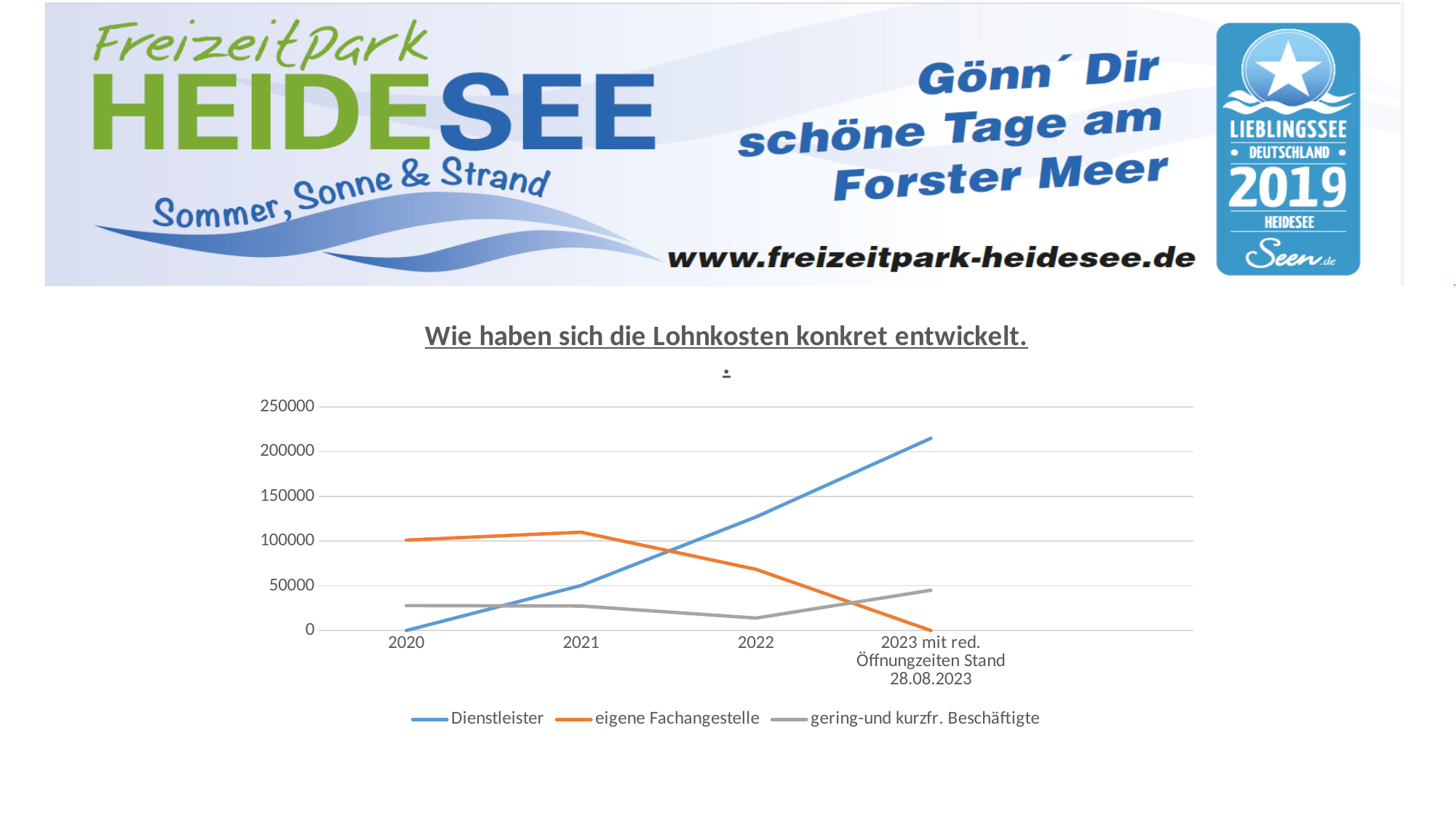
Which series has the highest value in 2020? eigene Fachangestelle How many series does the chart legend list? 3 In 2022, which is larger: Dienstleister or eigene Fachangestelle? Dienstleister Which series has the highest value in 2023 mit red. Öffnungzeiten Stand 28.08.2023? Dienstleister What is the value for Dienstleister in 2020? 0 What is the value for eigene Fachangestelle in 2023 mit red. Öffnungzeiten Stand 28.08.2023? 0 How many points along the x axis does each line have? 4 Is the value for eigene Fachangestelle in 2022 greater or less than 50000? greater Is the value for gering-und kurzfr. Beschäftigte in 2022 greater or less than 50000? less Does the Dienstleister line rise or fall from 2020 to 2023? rise Is the value for Dienstleister in 2023 mit red. Öffnungzeiten Stand 28.08.2023 greater or less than 200000? greater What kind of chart is shown on the slide? line chart